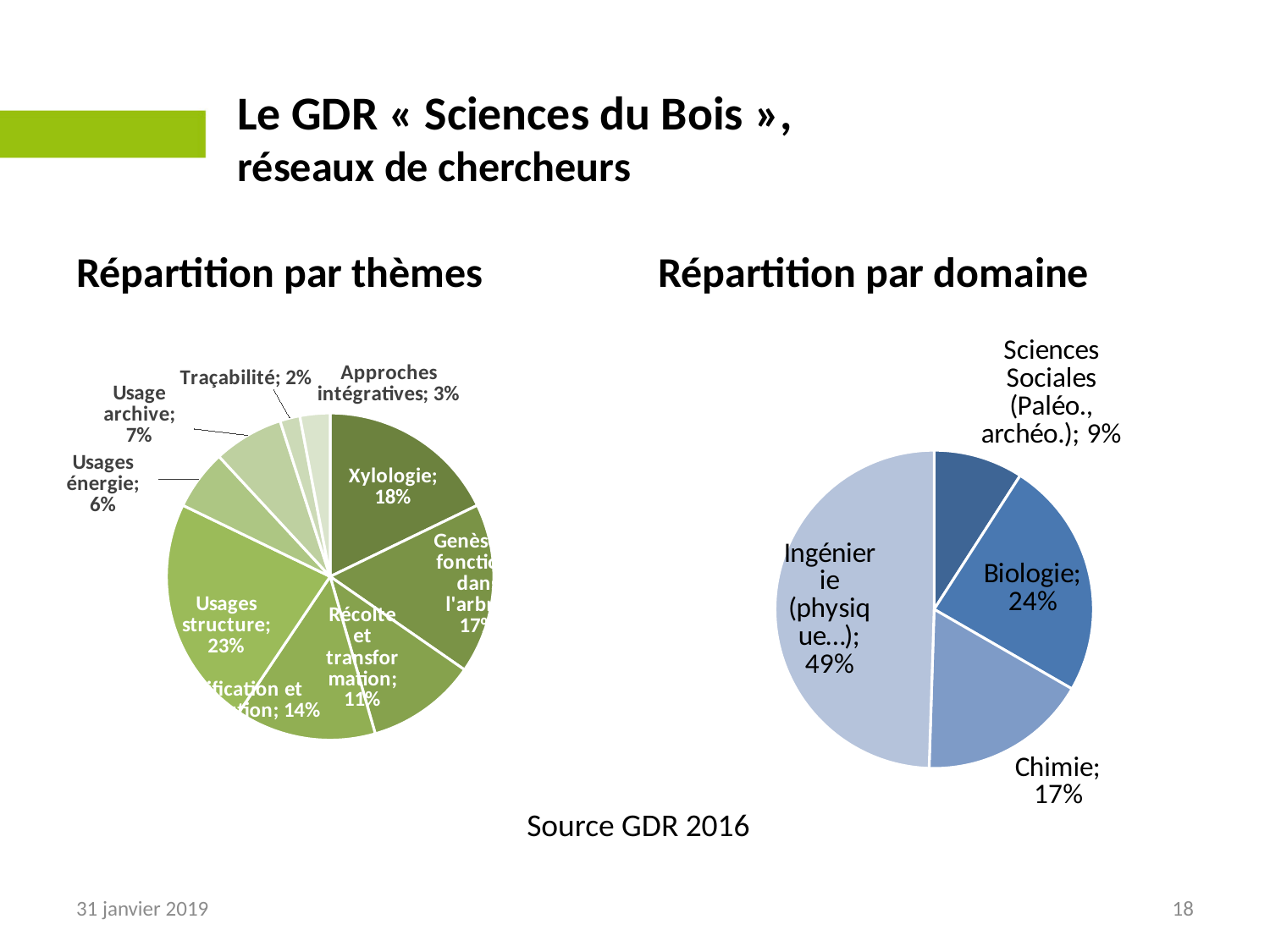
In the 'Répartition par domaine' chart, which domain has the smallest share? Sciences Sociales (Paléo., archéo.) In the 'Répartition par thèmes' chart, what share does Récolte et transformation have? 11% What kind of chart is used for 'Répartition par domaine'? pie chart In the 'Répartition par thèmes' chart, which theme has the smallest share? Traçabilité In the 'Répartition par thèmes' chart, which is larger: Usage archive or Usages énergie? Usage archive In the 'Répartition par domaine' chart, how many slices are there? 4 In the 'Répartition par thèmes' chart, what share does Xylologie have? 18% In the 'Répartition par domaine' chart, what share does Ingénierie (physique…) have? 49% In the 'Répartition par domaine' chart, what share does Biologie have? 24% In the 'Répartition par domaine' chart, what is the difference between the shares of Biologie and Chimie? 7% In the 'Répartition par thèmes' chart, what share does Usages structure have? 23% What source is cited below the charts? Source GDR 2016